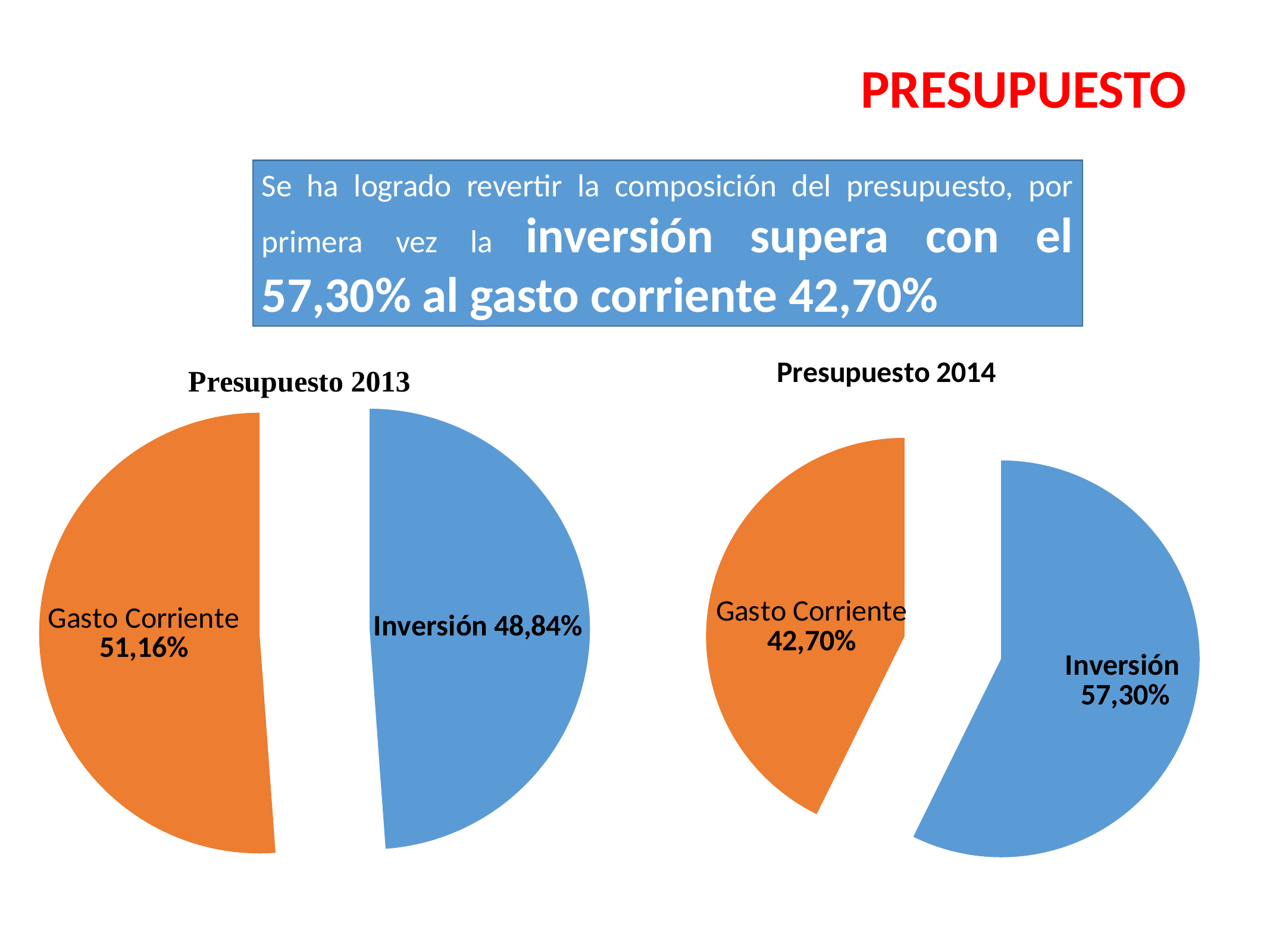
In the Presupuesto 2014 chart, what is the difference between Inversión and Gasto Corriente? 14,60% In the Presupuesto 2013 chart, what is the value for Inversión? 48,84% In the Presupuesto 2013 chart, what is the value for Gasto Corriente? 51,16% In the Presupuesto 2014 chart, what is the value for Inversión? 57,30% In the Presupuesto 2013 chart, what is the difference between Gasto Corriente and Inversión? 2,32% How many slices does the Presupuesto 2013 chart have? 2 What kind of chart is the Presupuesto 2014 chart? Pie chart In the Presupuesto 2014 chart, which slice is the largest? Inversión In the Presupuesto 2013 chart, which slice is the smallest? Inversión In the Presupuesto 2013 chart, what colour is the Inversión slice? Blue In the Presupuesto 2014 chart, which is larger, Gasto Corriente or Inversión? Inversión In the Presupuesto 2014 chart, what is the value for Gasto Corriente? 42,70%